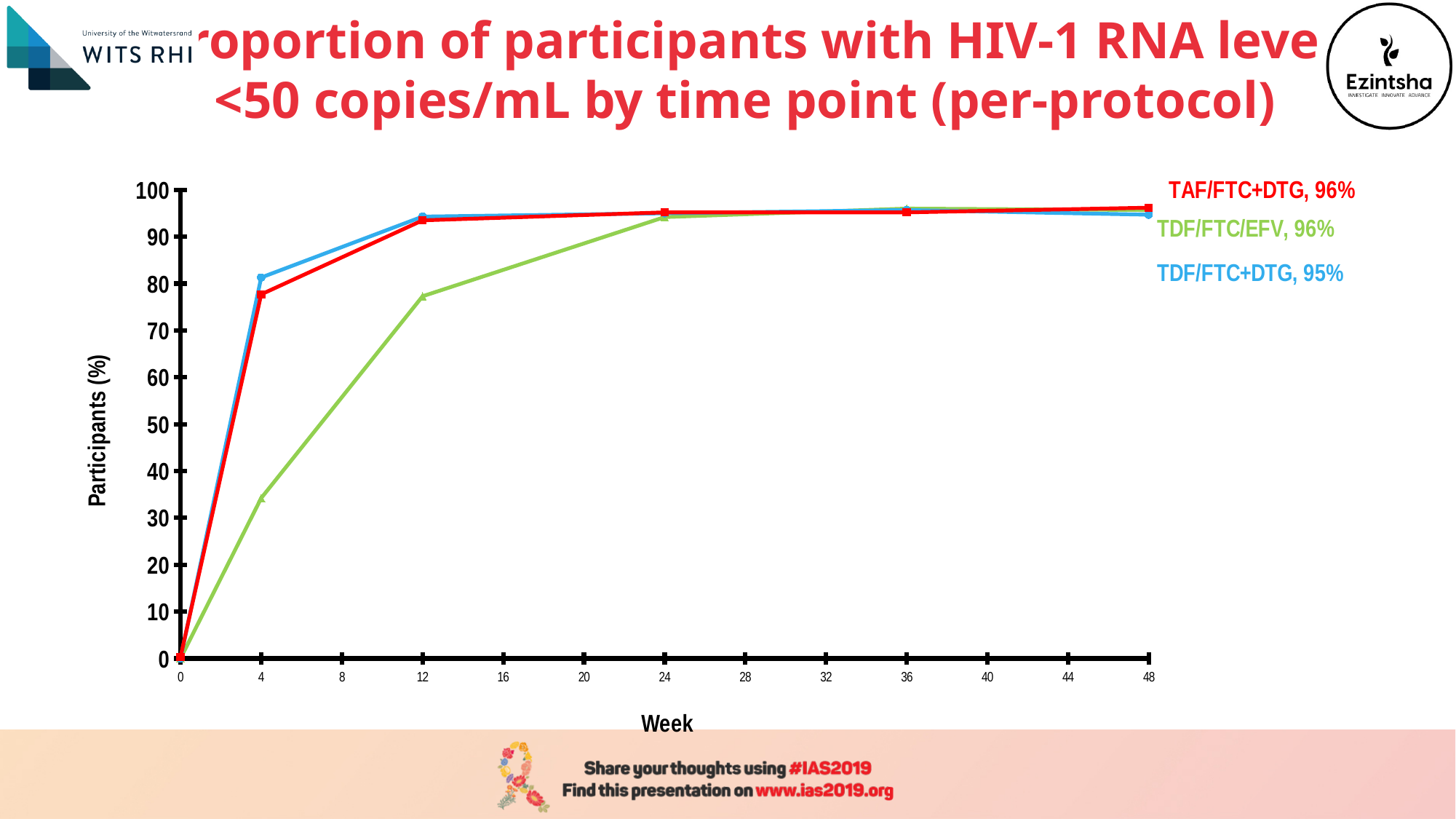
Is the value for TDF/FTC/EFV at week 4 greater or less than 50? less What is the value for TDF/FTC+DTG at week 48? 95% Is the value for TAF/FTC+DTG at week 4 greater or less than 70? greater Do the values for TDF/FTC/EFV rise or fall from week 0 to week 24? rise What kind of chart is shown on the slide? line chart What is the difference between the week 48 values for TAF/FTC+DTG and TDF/FTC+DTG? 1% What is the label on the y axis? Participants (%) At week 4, which is higher: TDF/FTC/EFV or TAF/FTC+DTG? TAF/FTC+DTG What is the value for TAF/FTC+DTG at week 48? 96% Which series has the lowest value at week 12? TDF/FTC/EFV What is the value for TDF/FTC/EFV at week 48? 96% How many series (treatment arms) are plotted on the chart? 3